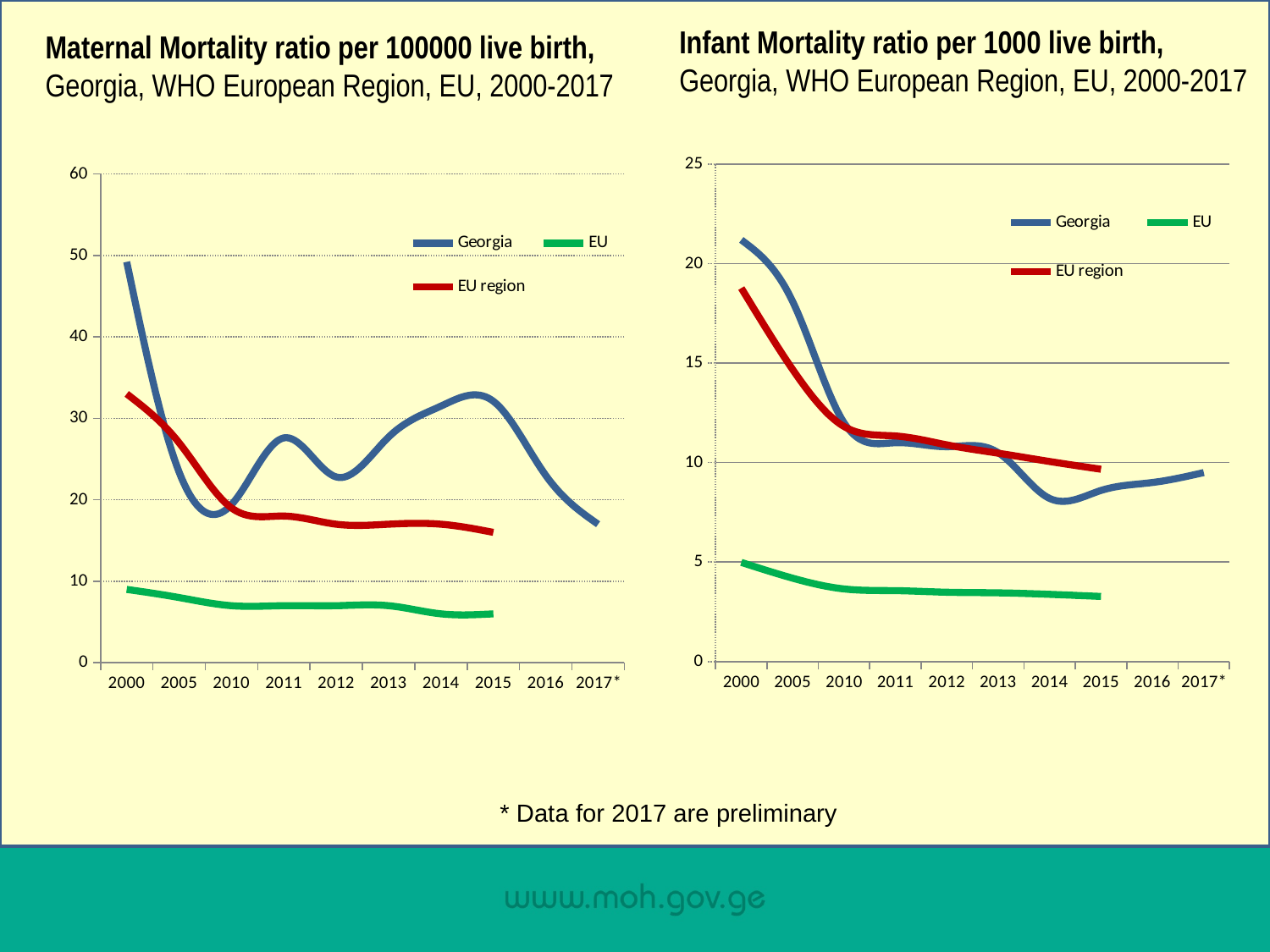
Which series is drawn in red in both charts? EU region How many years are labelled on the x axis of the Maternal Mortality chart on the left? 10 In the Maternal Mortality chart on the left, is the value for Georgia in 2000 greater or less than 40? greater In the Maternal Mortality chart on the left, is the value for Georgia in 2017* greater or less than 20? less In the Infant Mortality chart on the right, is the value for EU in 2015 greater or less than 5? less What kind of chart is the Maternal Mortality chart on the left? line chart In the Maternal Mortality chart on the left, which is larger in 2000, Georgia or EU region? Georgia In the Infant Mortality chart on the right, does the Georgia line overall rise or fall from 2000 to 2017*? fall How many series does the legend of the Infant Mortality chart on the right list? 3